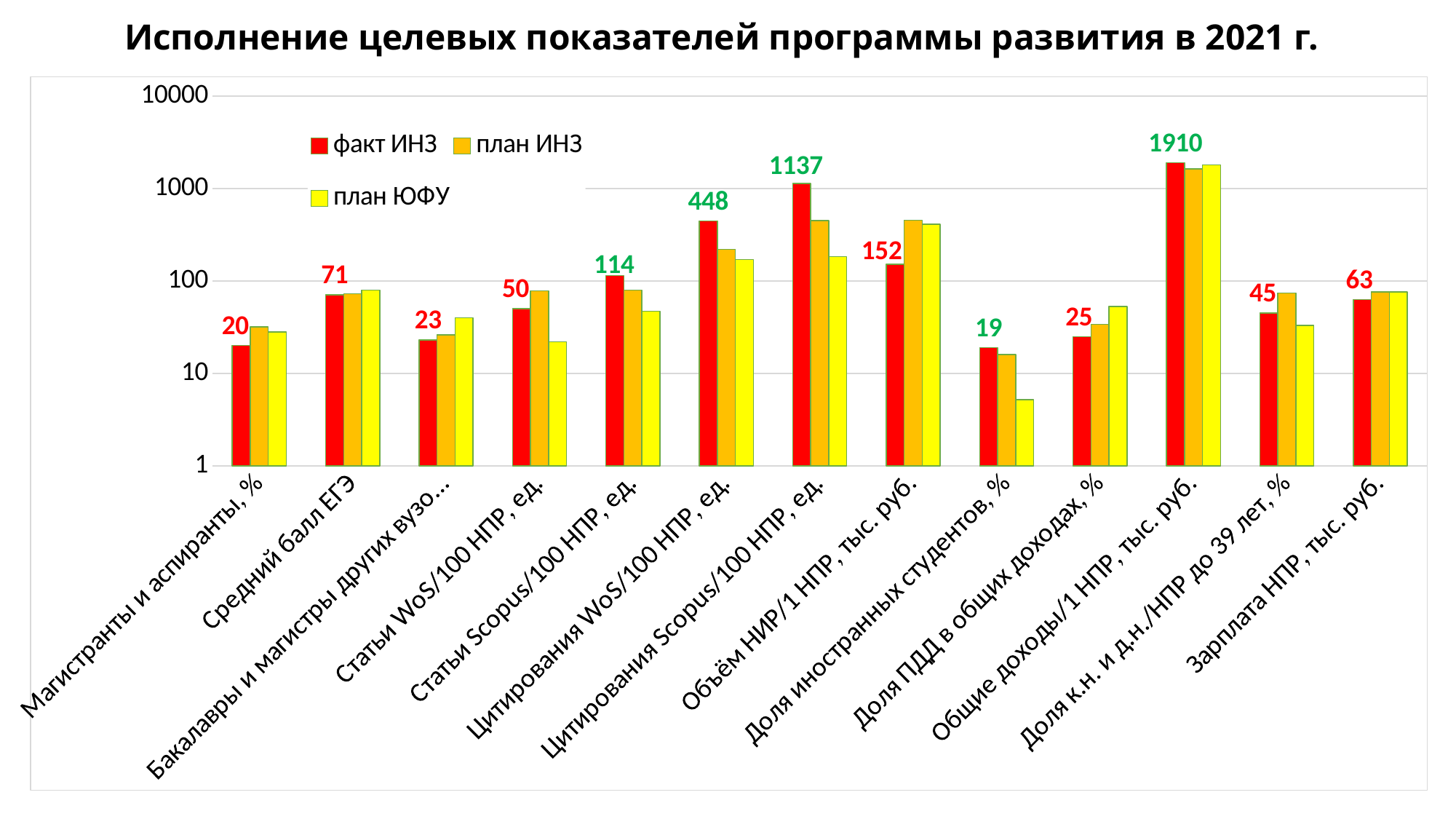
How many series does the legend list? 3 What is the difference between the факт ИНЗ values for Цитирования Scopus/100 НПР, ед. and Цитирования WoS/100 НПР, ед.? 689 Which category has the lowest факт ИНЗ value? Доля иностранных студентов, % Which is larger for Статьи WoS/100 НПР, ед.: факт ИНЗ or план ИНЗ? план ИНЗ What is the value of факт ИНЗ for Зарплата НПР, тыс. руб.? 63 Which category has the highest факт ИНЗ value? Общие доходы/1 НПР, тыс. руб. What is the value of факт ИНЗ for Средний балл ЕГЭ? 71 How many categories are shown on the x axis? 13 What is the value of факт ИНЗ for Общие доходы/1 НПР, тыс. руб.? 1910 What is the value of факт ИНЗ for Цитирования Scopus/100 НПР, ед.? 1137 What type of chart is shown on the slide? bar chart Is the план ЮФУ value for Доля иностранных студентов, % greater or less than 10? less